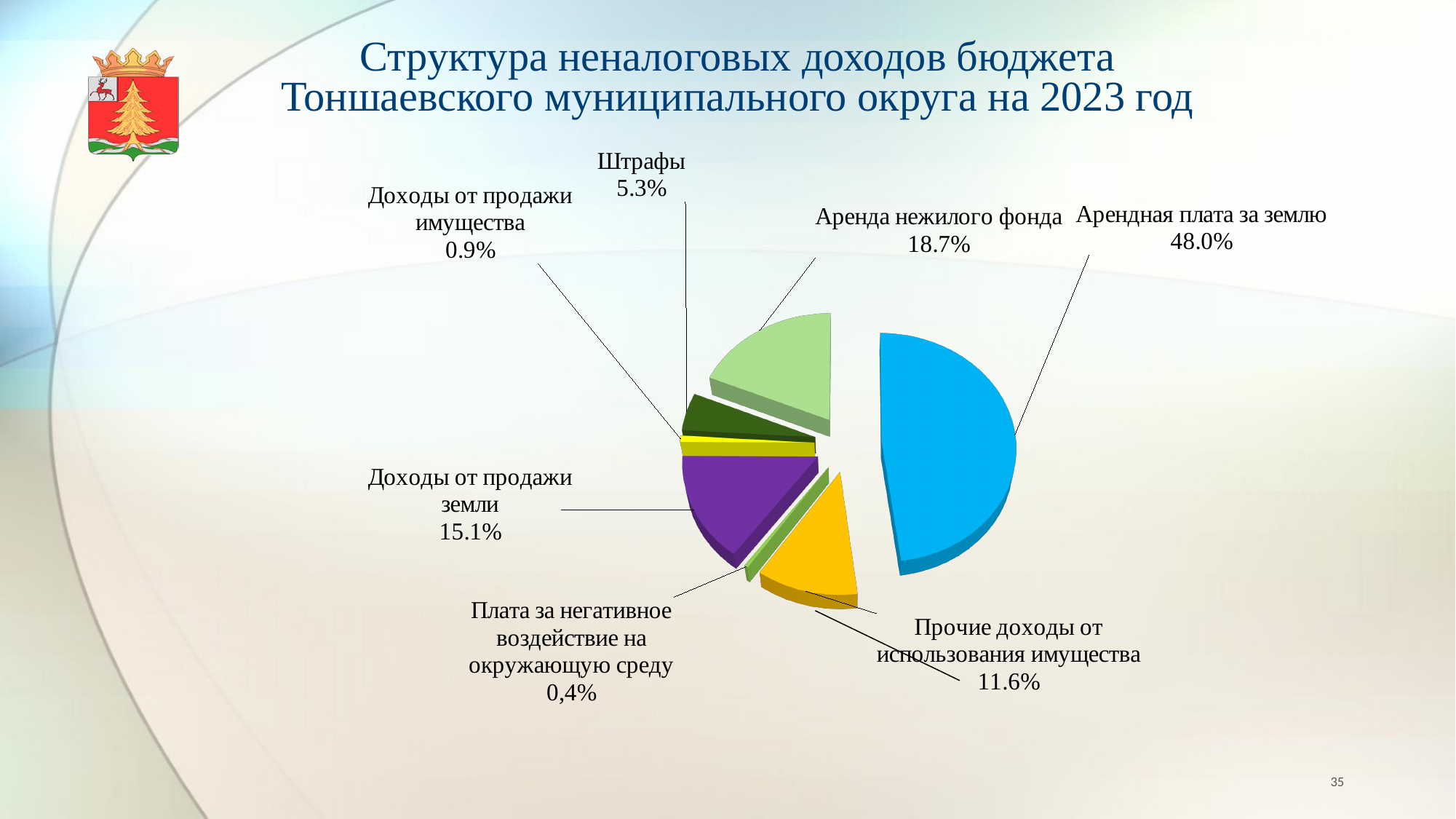
What is the value for Плата за негативное воздействие на окружающую среду? 0,4% What share of non-tax revenue comes from Арендная плата за землю? 48.0% What percentage is shown for Штрафы? 5.3% What is the difference in percentage points between Арендная плата за землю and Аренда нежилого фонда? 29.3 Which category has the smallest share of the pie? Плата за негативное воздействие на окружающую среду What is the value shown for Аренда нежилого фонда? 18.7% What share is shown for Прочие доходы от использования имущества? 11.6% Which is larger: Доходы от продажи земли or Прочие доходы от использования имущества? Доходы от продажи земли What kind of chart is shown on the slide? Pie chart What is the title of the chart on the slide? Структура неналоговых доходов бюджета Тоншаевского муниципального округа на 2023 год Which category has the largest share of the pie? Арендная плата за землю How many categories are shown in the pie chart? 7